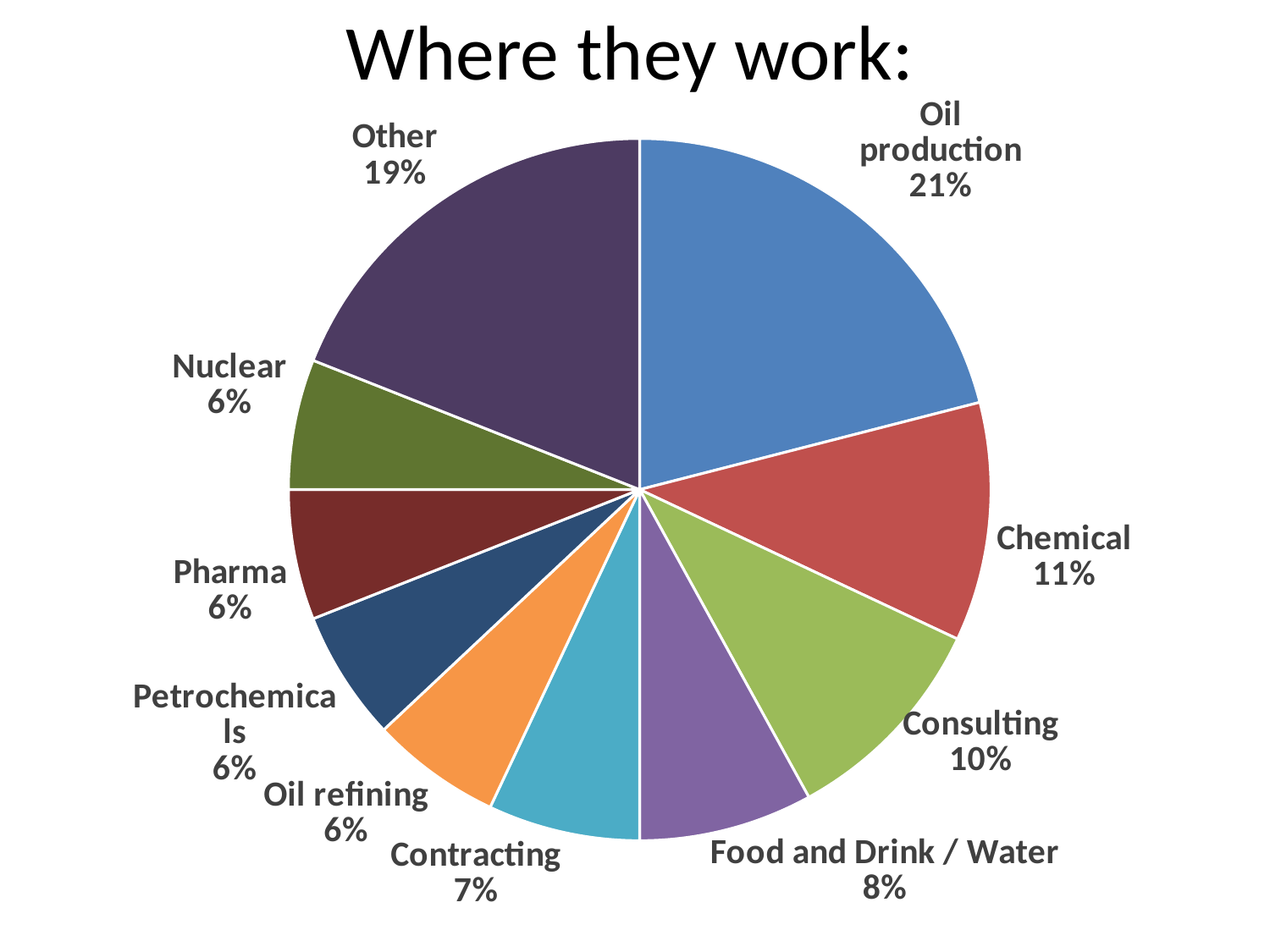
What is the value for Contracting? 7% How many categories are shown in the pie chart? 10 What is the value for Consulting? 10% What is the difference between Chemical and Consulting? 1% What is the value for Nuclear? 6% What is the difference between Oil production and Other? 2% What is the value for Food and Drink / Water? 8% Which category has the largest slice? Oil production What is the title of the chart? Where they work: What kind of chart is shown on the slide? pie chart Which is larger, Other or Chemical? Other What share of the pie is Oil production? 21%